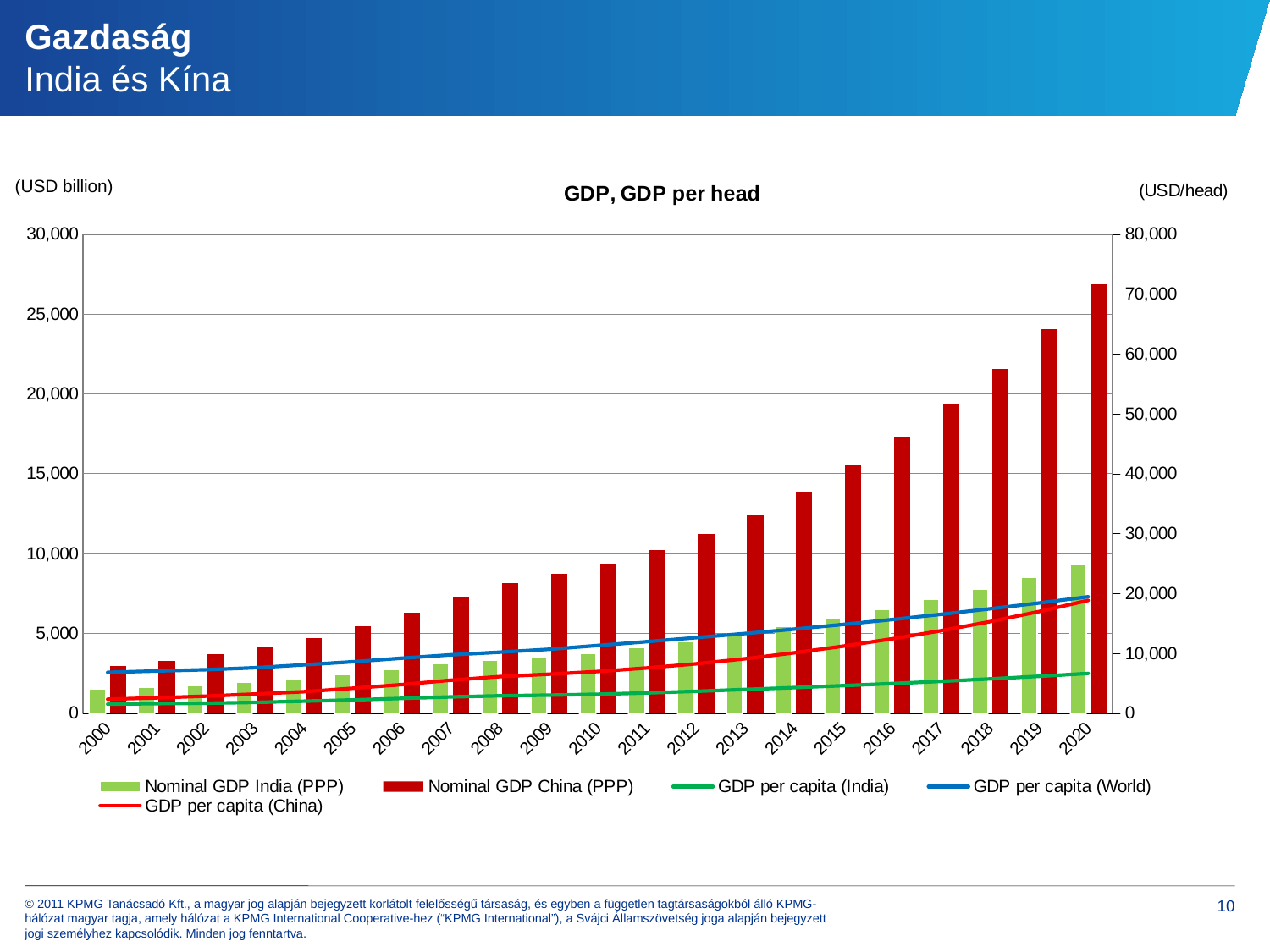
What kind of chart is shown on the slide? A combined bar and line chart What is the title of the chart? GDP, GDP per head Is the Nominal GDP China (PPP) value for 2016 greater or less than 15,000? greater Do the Nominal GDP China (PPP) bars rise or fall from 2000 to 2020? rise Which is larger in 2020, Nominal GDP China (PPP) or Nominal GDP India (PPP)? Nominal GDP China (PPP) Is the Nominal GDP China (PPP) value for 2020 greater or less than 25,000? greater In which year is the Nominal GDP China (PPP) bar the highest? 2020 Is the Nominal GDP India (PPP) value for 2020 greater or less than 10,000? less In which year is the Nominal GDP China (PPP) bar the lowest? 2000 How many series does the chart legend list? 5 How many years are shown along the x axis of the chart? 21